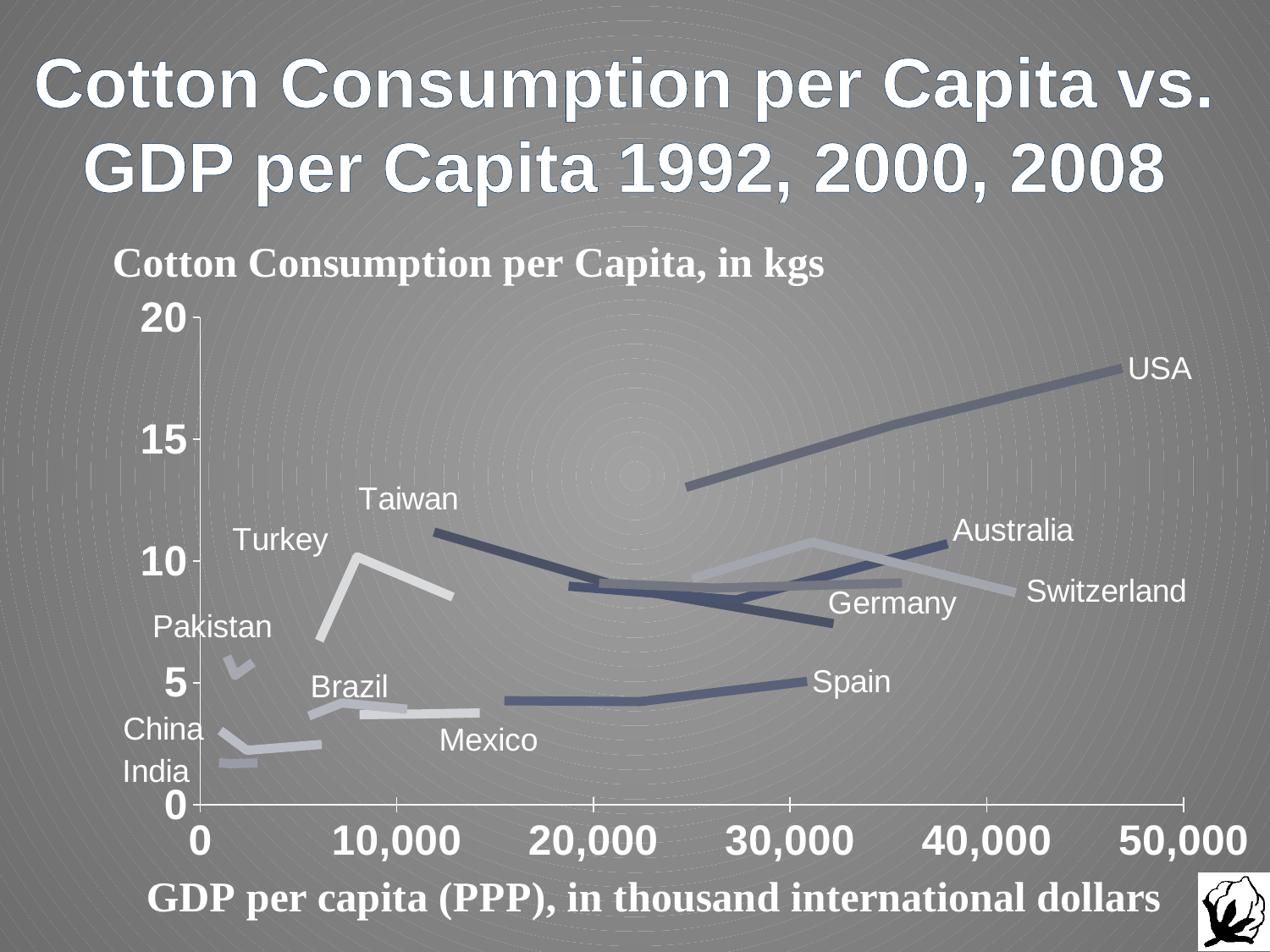
How many countries are labelled on the chart? 12 Which has higher cotton consumption per capita, the USA or Spain? USA Is the cotton consumption per capita for Mexico greater or less than 5 kgs? less Which country has the highest cotton consumption per capita on the chart? USA What kind of chart is shown on the slide? line chart Is the highest cotton consumption value for the USA greater or less than 15 kgs? greater Does the USA line rise or fall as GDP per capita increases? rises What is the label of the vertical axis? Cotton Consumption per Capita, in kgs Which country has the lowest cotton consumption per capita on the chart? India What is the label of the horizontal axis? GDP per capita (PPP), in thousand international dollars Is the cotton consumption per capita for Germany greater or less than 10 kgs? less